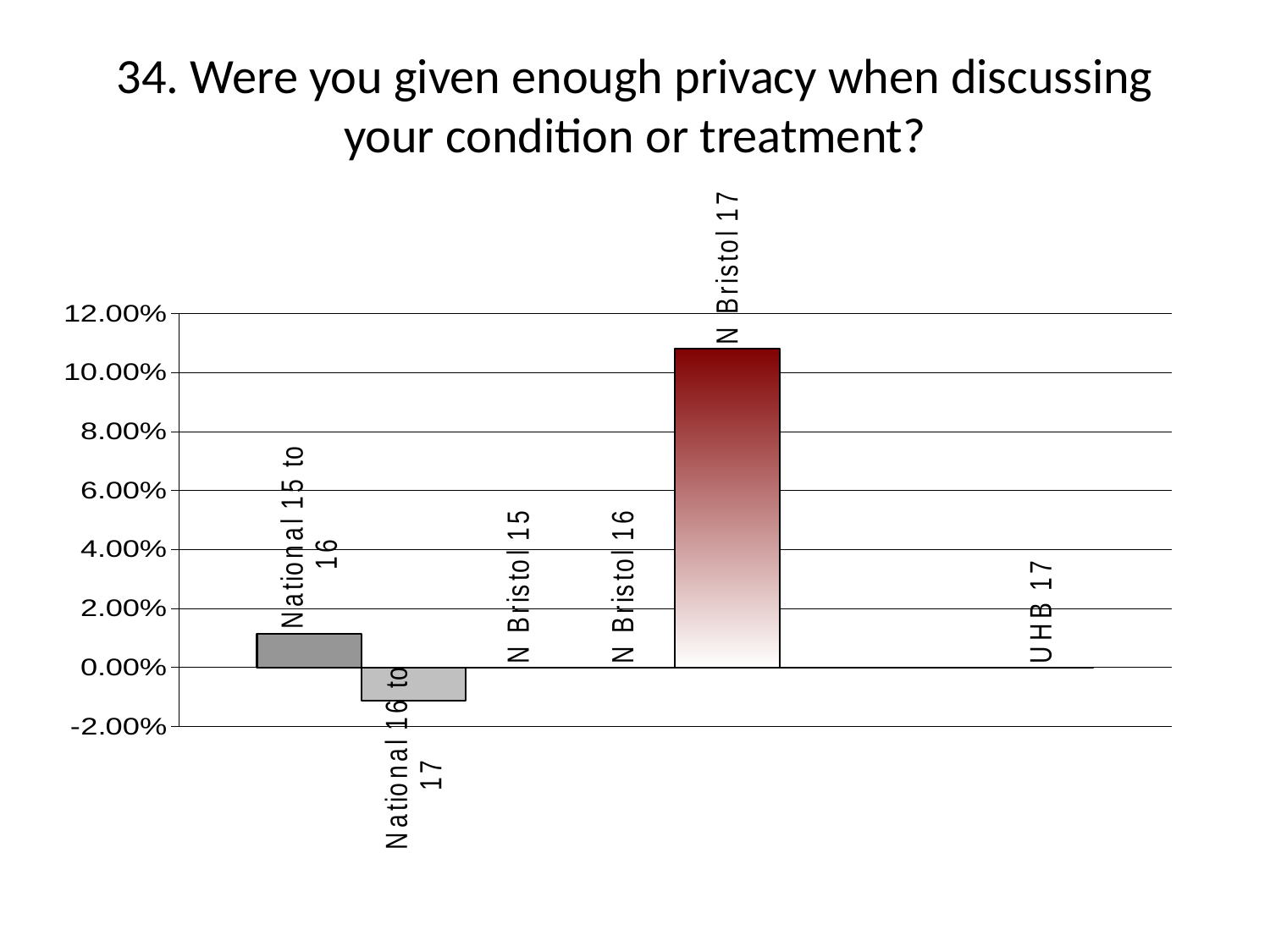
Is the value for National 15 to 16 greater or less than 2.00%? less What is the title of the chart? 34. Were you given enough privacy when discussing your condition or treatment? Which category has the highest value? N Bristol 17 Is the value for N Bristol 17 greater or less than 10.00%? greater Which is larger, the value for N Bristol 17 or the value for National 15 to 16? N Bristol 17 Which category has the lowest value? National 16 to 17 What is the highest value shown on the vertical axis? 12.00% Which is larger, the value for National 15 to 16 or the value for National 16 to 17? National 15 to 16 What kind of chart is shown on the slide? bar chart Is the value for N Bristol 17 greater or less than 12.00%? less